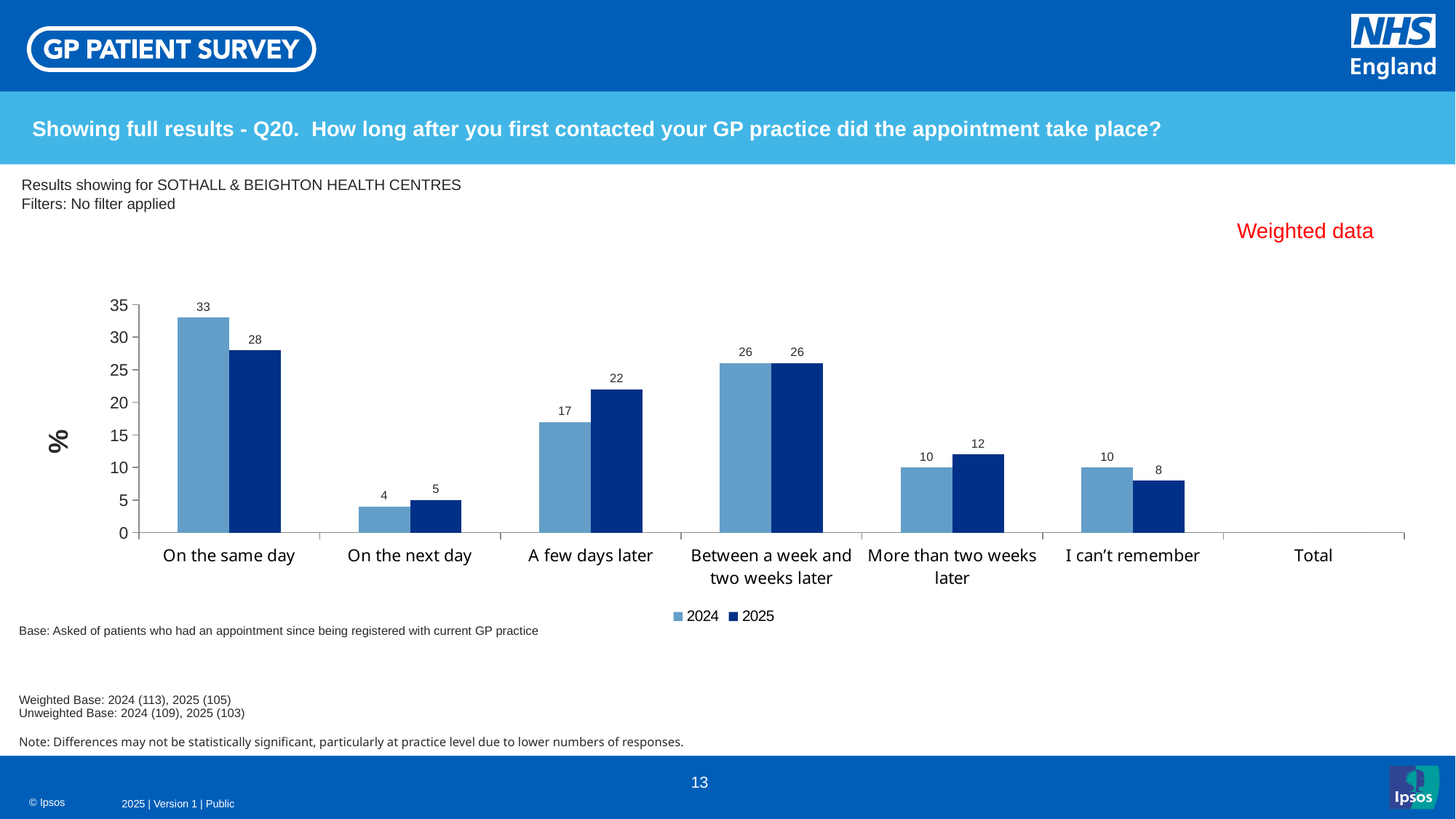
What is the 2024 value for 'On the same day'? 33 What is the 2025 value for 'I can't remember'? 8 What is the 2025 value for 'A few days later'? 22 Which category has the lowest 2025 value? On the next day What label is shown on the y axis of the chart? % What kind of chart is shown on the slide? Bar chart How many series does the legend list? 2 Is the 2025 value for 'Between a week and two weeks later' greater or less than 20? greater Which is larger for 'A few days later': the 2024 value or the 2025 value? 2025 Which category has the highest 2024 value? On the same day What is the 2024 value for 'More than two weeks later'? 10 What is the difference between the 2024 and 2025 values for 'On the same day'? 5